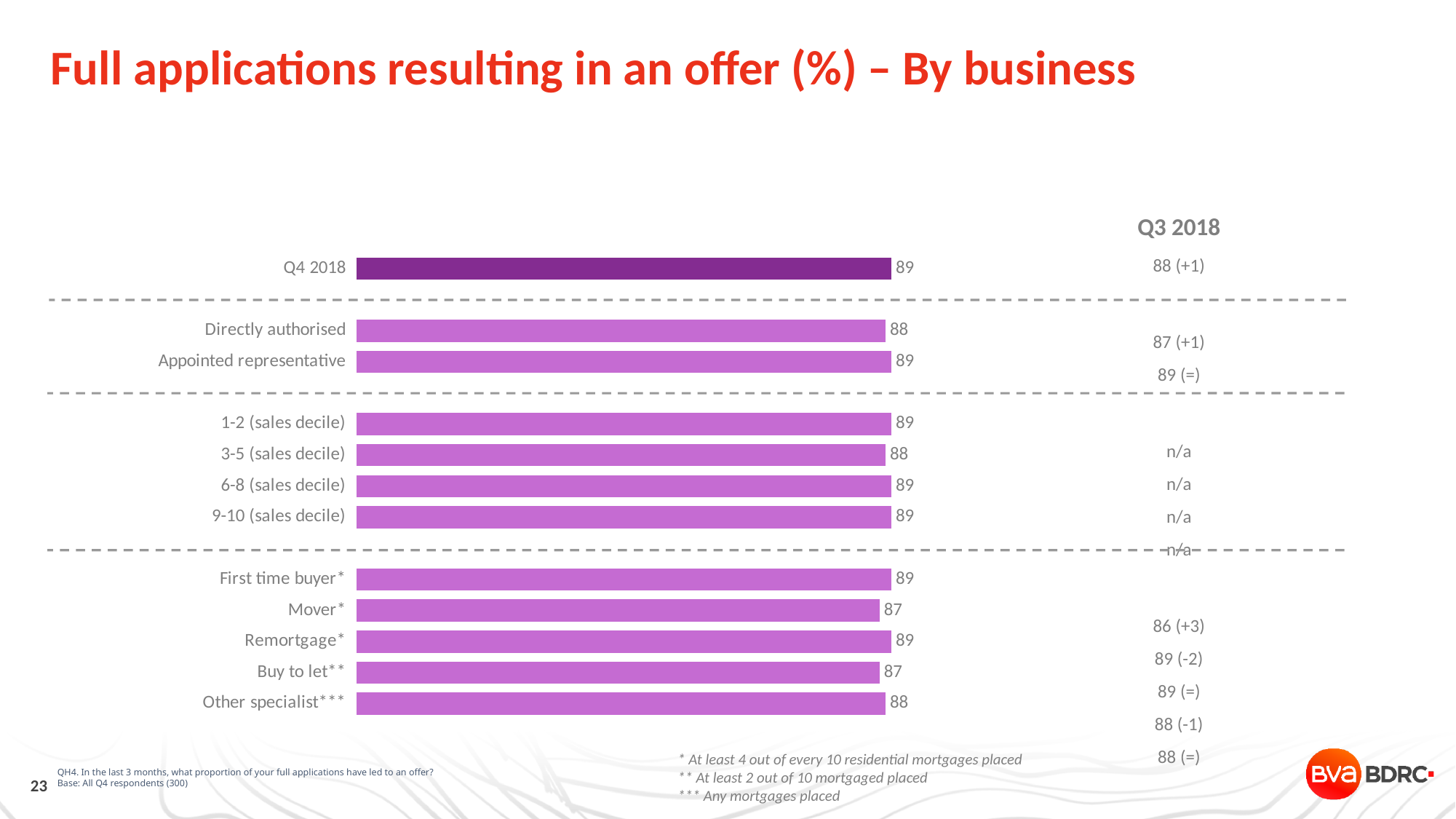
What Q3 2018 figure is shown next to the Q4 2018 overall bar? 88 (+1) What is the value for Mover*? 87 Which is larger, the value for First time buyer* or the value for Mover*? First time buyer* What kind of chart is shown on the slide? Bar chart What is the value for Other specialist***? 88 What is the value for 3-5 (sales decile)? 88 What is the difference between the value for Appointed representative and the value for Directly authorised? 1 What is the value for Directly authorised? 88 How many bars are plotted on the chart? 12 What is the value for Q4 2018 overall? 89 What is the difference between the value for Remortgage* and the value for Buy to let**? 2 What is the value for Buy to let**? 87